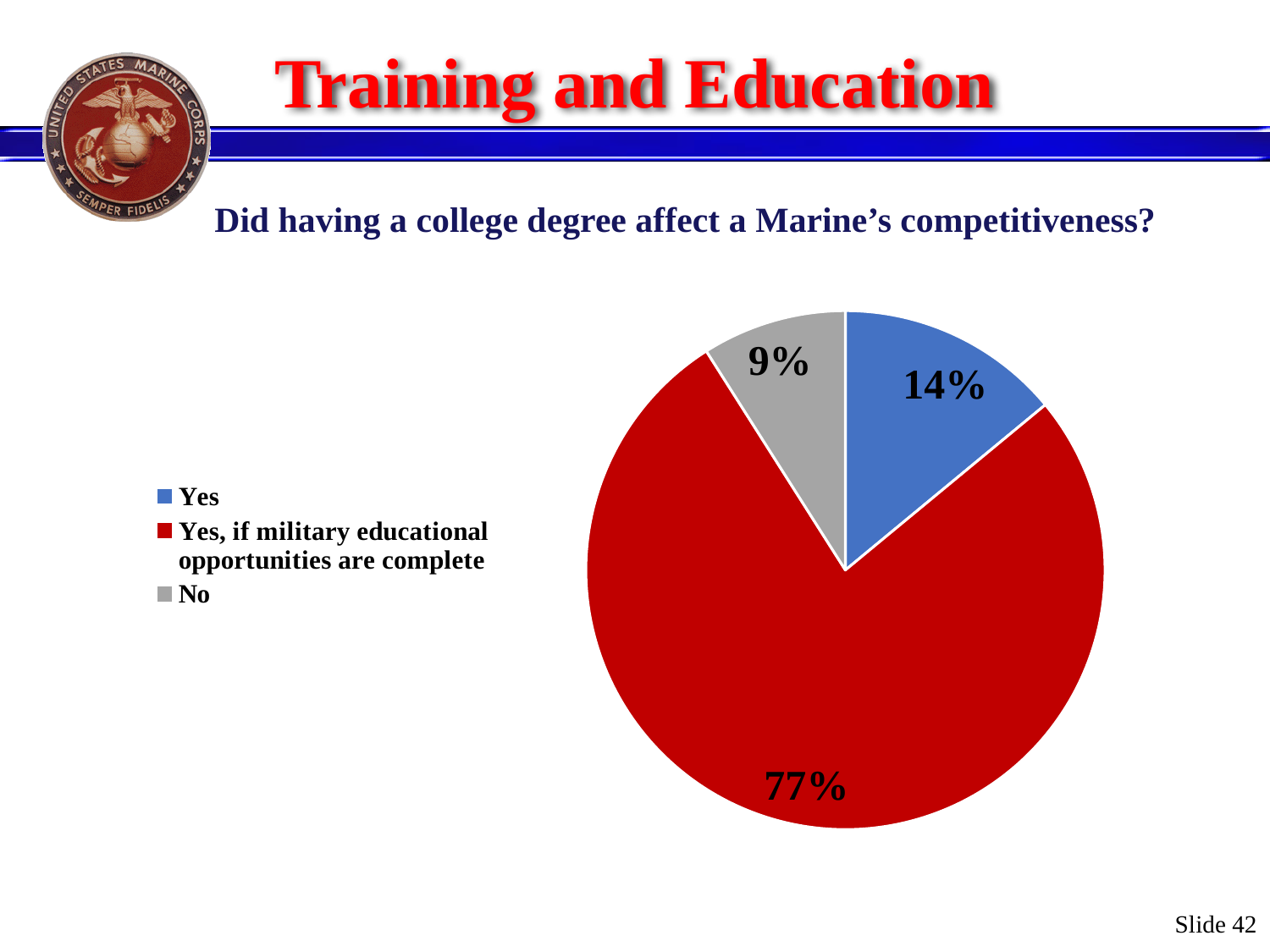
What kind of chart is shown on the slide? pie chart How many slices does the pie chart have? 3 What question does the pie chart answer, according to the text above it? Did having a college degree affect a Marine's competitiveness? What percentage of the pie is the "Yes" slice? 14% Which is larger, the "Yes" slice or the "No" slice? Yes What is the difference in percentage points between the "Yes, if military educational opportunities are complete" slice and the "Yes" slice? 63 How many entries does the legend list? 3 What colour is the "No" slice? gray Which response has the largest share of the pie? Yes, if military educational opportunities are complete Which response has the smallest share of the pie? No What percentage of the pie is the "No" slice? 9% What percentage of the pie is the "Yes, if military educational opportunities are complete" slice? 77%